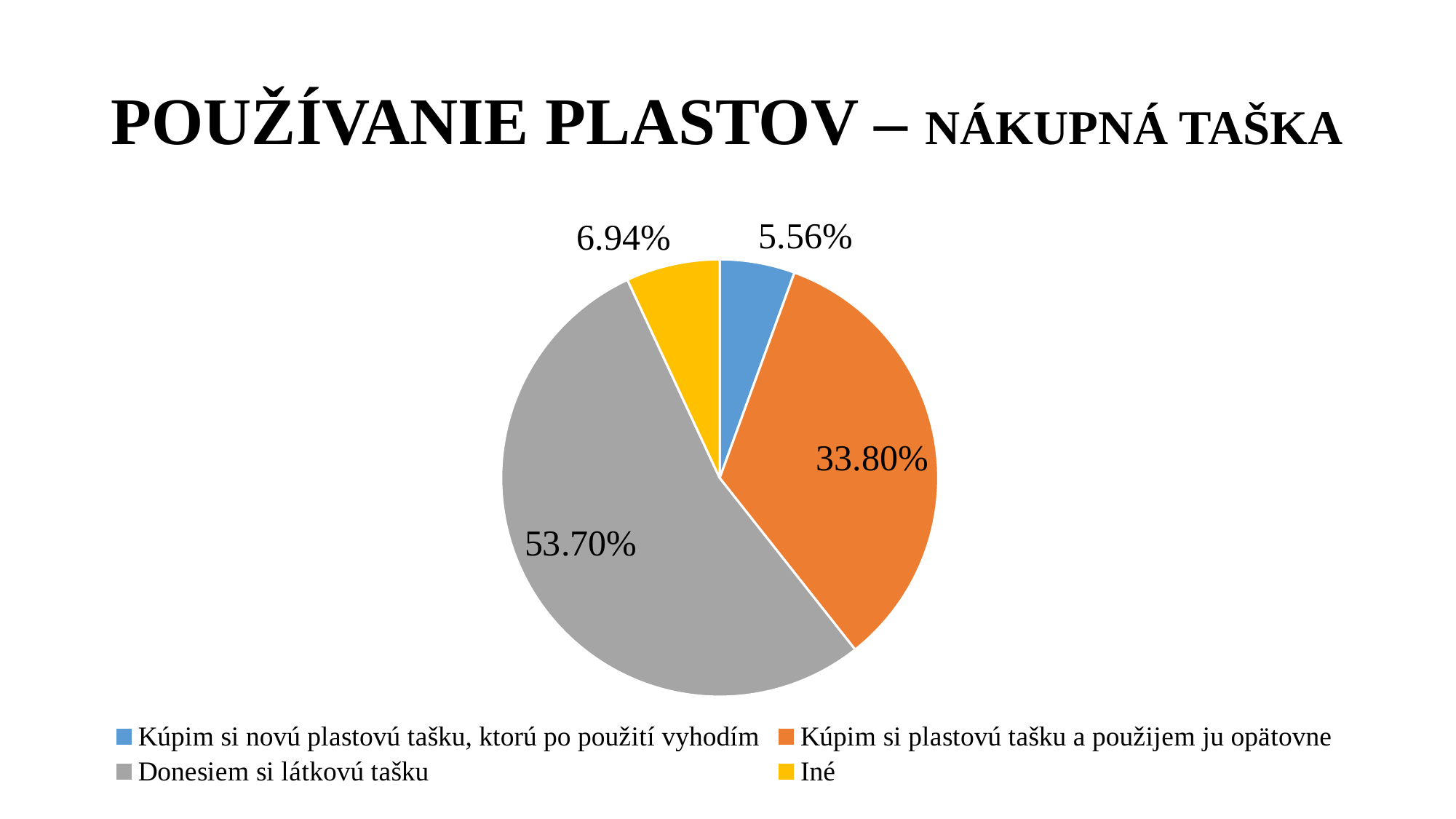
What is the value for "Kúpim si novú plastovú tašku, ktorú po použití vyhodím"? 5.56% How many categories does the pie chart have? 4 What is the value for "Kúpim si plastovú tašku a použijem ju opätovne"? 33.80% What is the difference between the values for "Donesiem si látkovú tašku" and "Kúpim si plastovú tašku a použijem ju opätovne"? 19.90% Which category has the smallest slice of the pie? Kúpim si novú plastovú tašku, ktorú po použití vyhodím What kind of chart is shown on the slide? pie chart Which is larger, the value for "Iné" or the value for "Kúpim si novú plastovú tašku, ktorú po použití vyhodím"? Iné What is the title of the slide containing the chart? POUŽÍVANIE PLASTOV – NÁKUPNÁ TAŠKA What share of the pie does "Donesiem si látkovú tašku" have? 53.70% What colour is the slice for "Iné"? yellow Which category has the largest slice of the pie? Donesiem si látkovú tašku What is the value for "Iné"? 6.94%